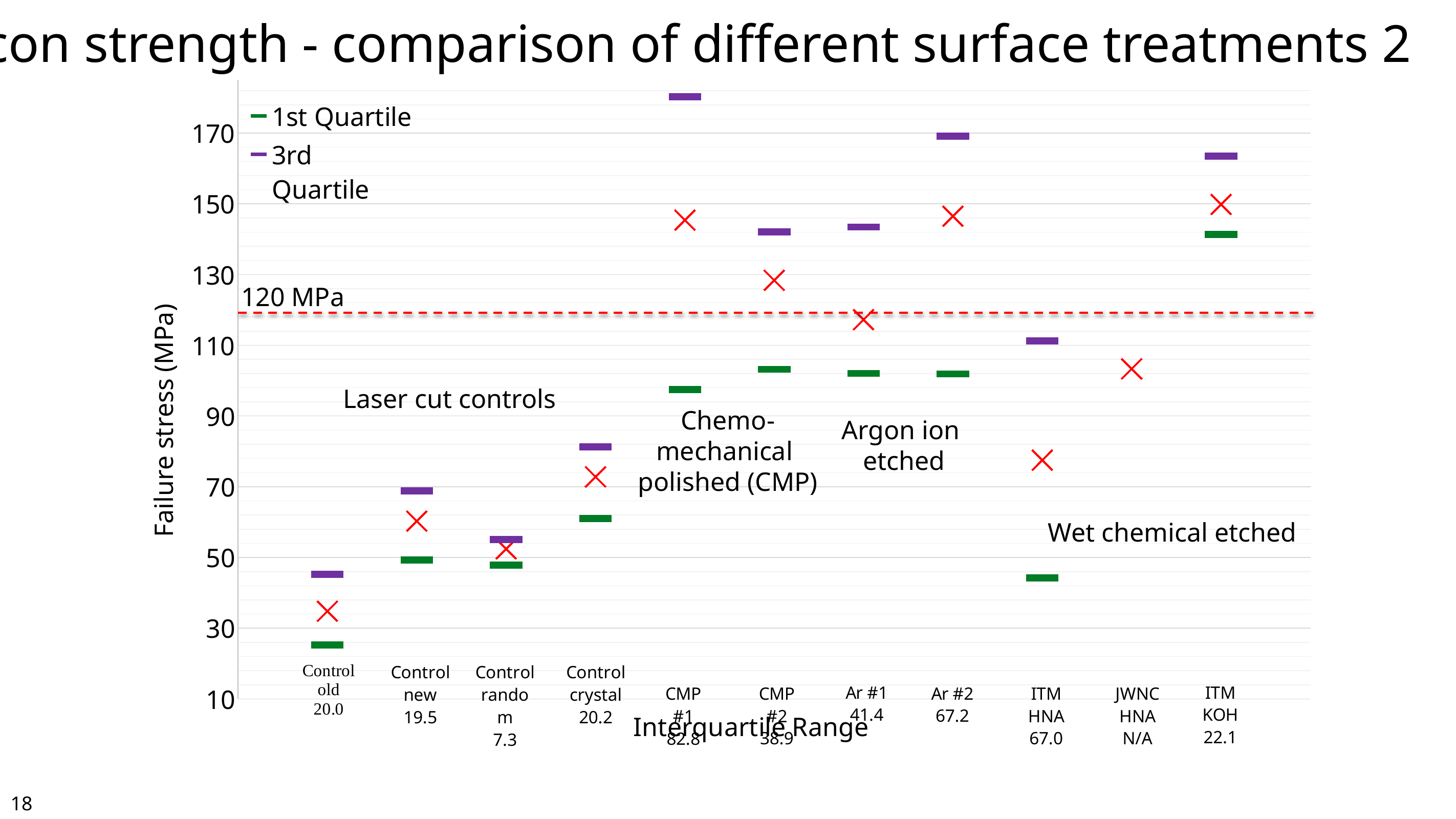
Which has the higher 3rd Quartile value, Ar #2 or CMP #2? Ar #2 What is the interquartile range printed for CMP #1? 82.8 Is the 1st Quartile value for Control old greater or less than 30? less What is the interquartile range printed for JWNC HNA? N/A Which category has the smallest printed interquartile range? Control random What is the difference between the printed interquartile ranges of Ar #2 and Ar #1? 25.8 What is the label of the y axis? Failure stress (MPa) How many categories are shown along the x axis? 11 What is the interquartile range printed for Control random? 7.3 Is the 3rd Quartile value for CMP #1 greater or less than 170? greater How many series does the legend list? 2 Which category has the largest printed interquartile range? CMP #1